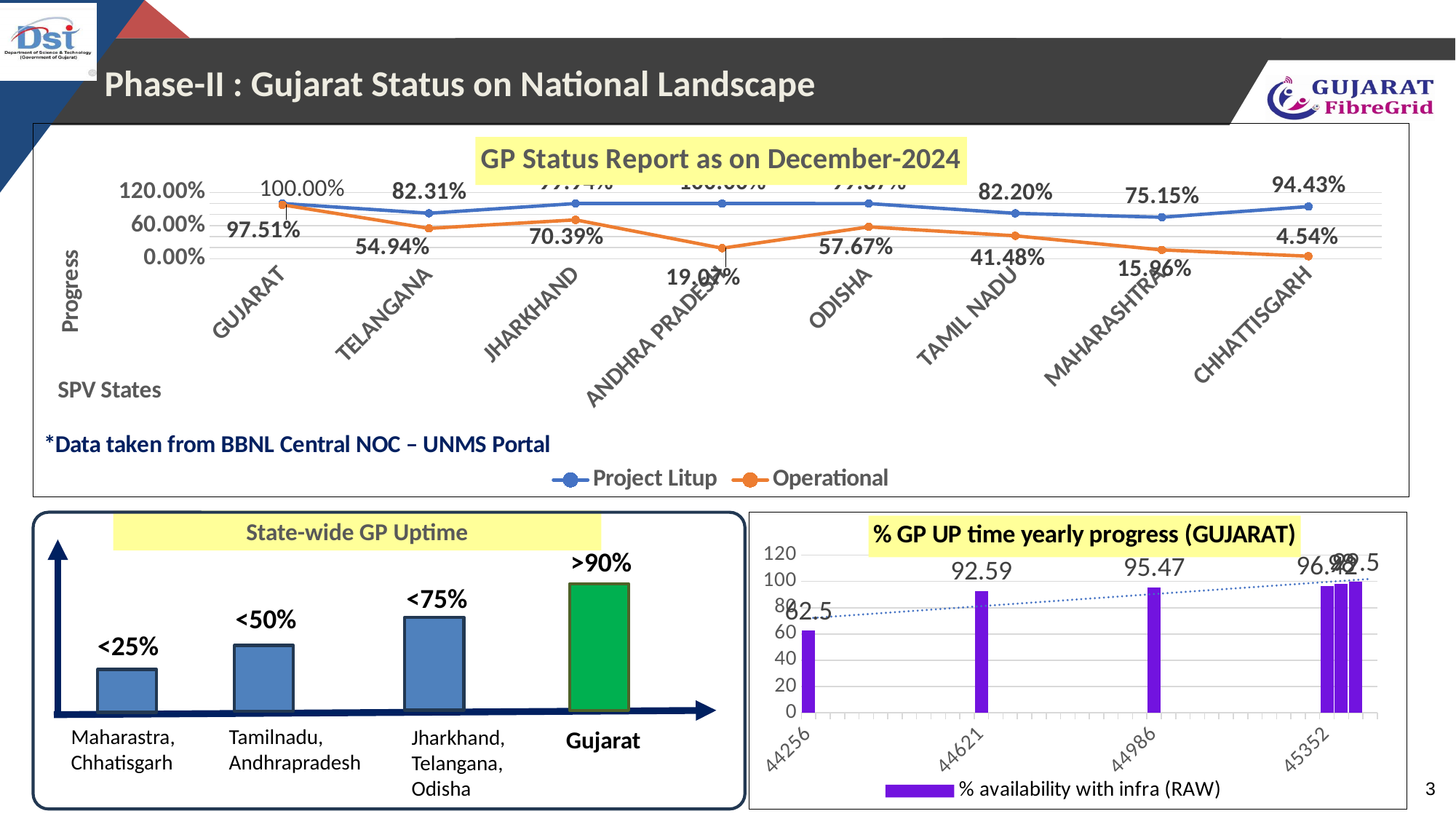
In the 'GP Status Report as on December-2024' chart, what is the difference between the Project Litup and Operational values for TAMIL NADU? 40.72% In the 'GP Status Report as on December-2024' chart, what is the Operational value for GUJARAT? 97.51% In the 'GP Status Report as on December-2024' chart, which is larger: the Operational value for JHARKHAND or for ODISHA? JHARKHAND In the '% GP UP time yearly progress (GUJARAT)' chart, what is the value of the bar at 44621? 92.59 What kind of chart is the 'GP Status Report as on December-2024' chart? Line chart In the 'State-wide GP Uptime' chart, what is the label shown above the bar for Gujarat? >90% In the '% GP UP time yearly progress (GUJARAT)' chart, is the value of the bar at 44256 greater or less than 80? less In the 'GP Status Report as on December-2024' chart, what is the Project Litup value for TELANGANA? 82.31% How many series does the legend of the 'GP Status Report as on December-2024' chart list? 2 In the 'GP Status Report as on December-2024' chart, what is the Operational value for CHHATTISGARH? 4.54% In the 'GP Status Report as on December-2024' chart, which state has the lowest Operational value? CHHATTISGARH How many states are plotted on the x axis of the 'GP Status Report as on December-2024' chart? 8